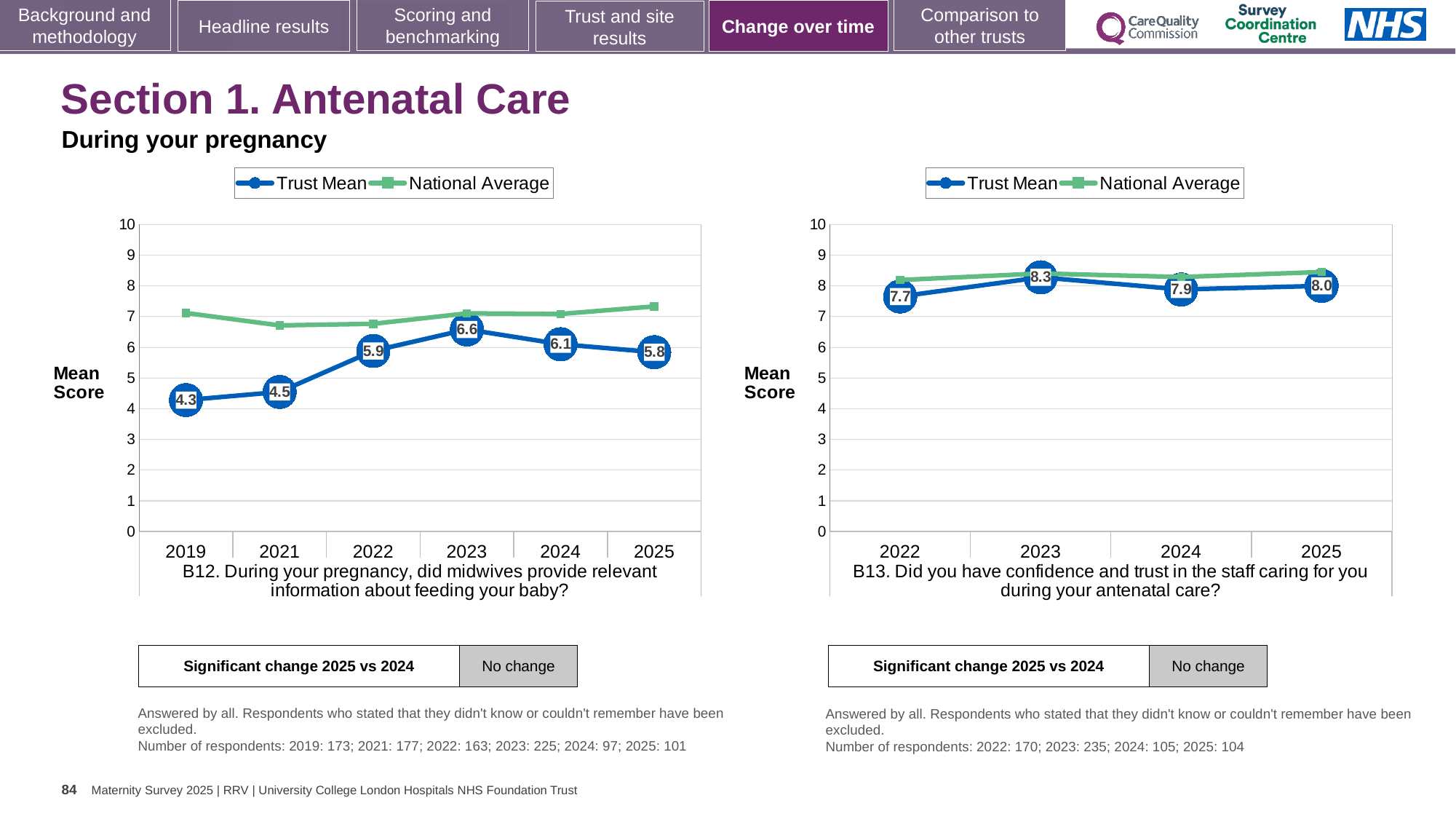
In the B12 chart (left), which year has the lowest Trust Mean? 2019 In the B13 chart (right), which year has the lowest Trust Mean? 2022 In the B12 chart (left), what is the Trust Mean for 2019? 4.3 In the B13 chart (right), what is the Trust Mean for 2023? 8.3 In the B13 chart (right), which is larger, the Trust Mean for 2022 or the Trust Mean for 2024? 2024 In the B12 chart (left), which year has the highest Trust Mean? 2023 What kind of chart is the B13 chart (right)? Line chart In the B12 chart (left), is the National Average for 2025 greater or less than 7? greater In the B13 chart (right), how many series does the legend list? 2 In the B12 chart (left), how many years are shown on the x axis? 6 In the B12 chart (left), what is the difference between the Trust Mean for 2023 and the Trust Mean for 2019? 2.3 In the B12 chart (left), what is the Trust Mean for 2025? 5.8